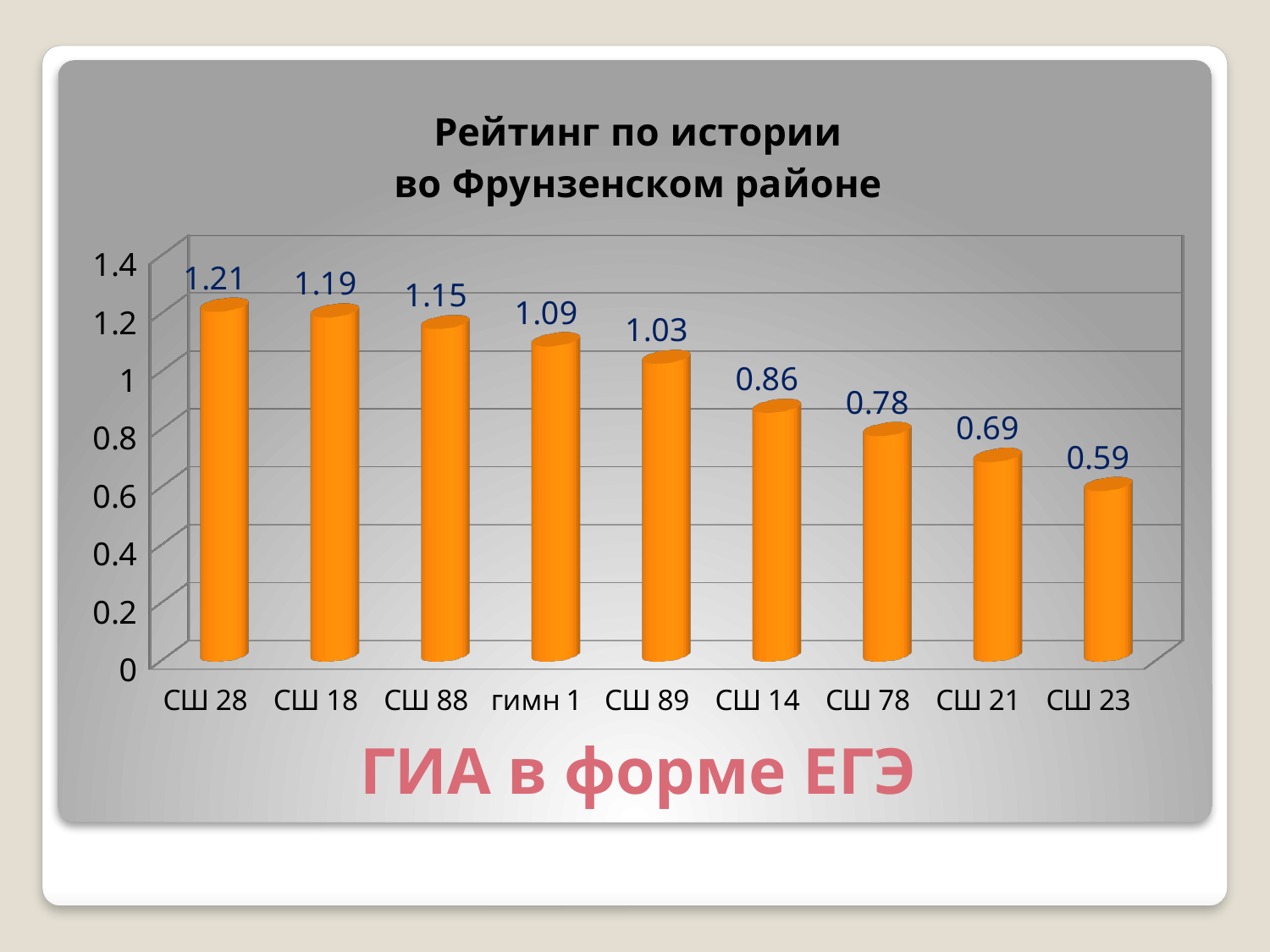
Do the values rise or fall from left to right along the x axis? fall Which is larger, the value for СШ 88 or the value for СШ 21? СШ 88 What is the value for СШ 28? 1.21 What is the value for гимн 1? 1.09 What is the difference between the values for СШ 89 and СШ 14? 0.17 Which school has the highest rating? СШ 28 What kind of chart is shown? bar chart How many schools are shown on the chart? 9 Is the value for СШ 14 greater or less than 1? less What is the difference between the values for СШ 28 and СШ 23? 0.62 What is the value for СШ 78? 0.78 Which school has the lowest rating? СШ 23